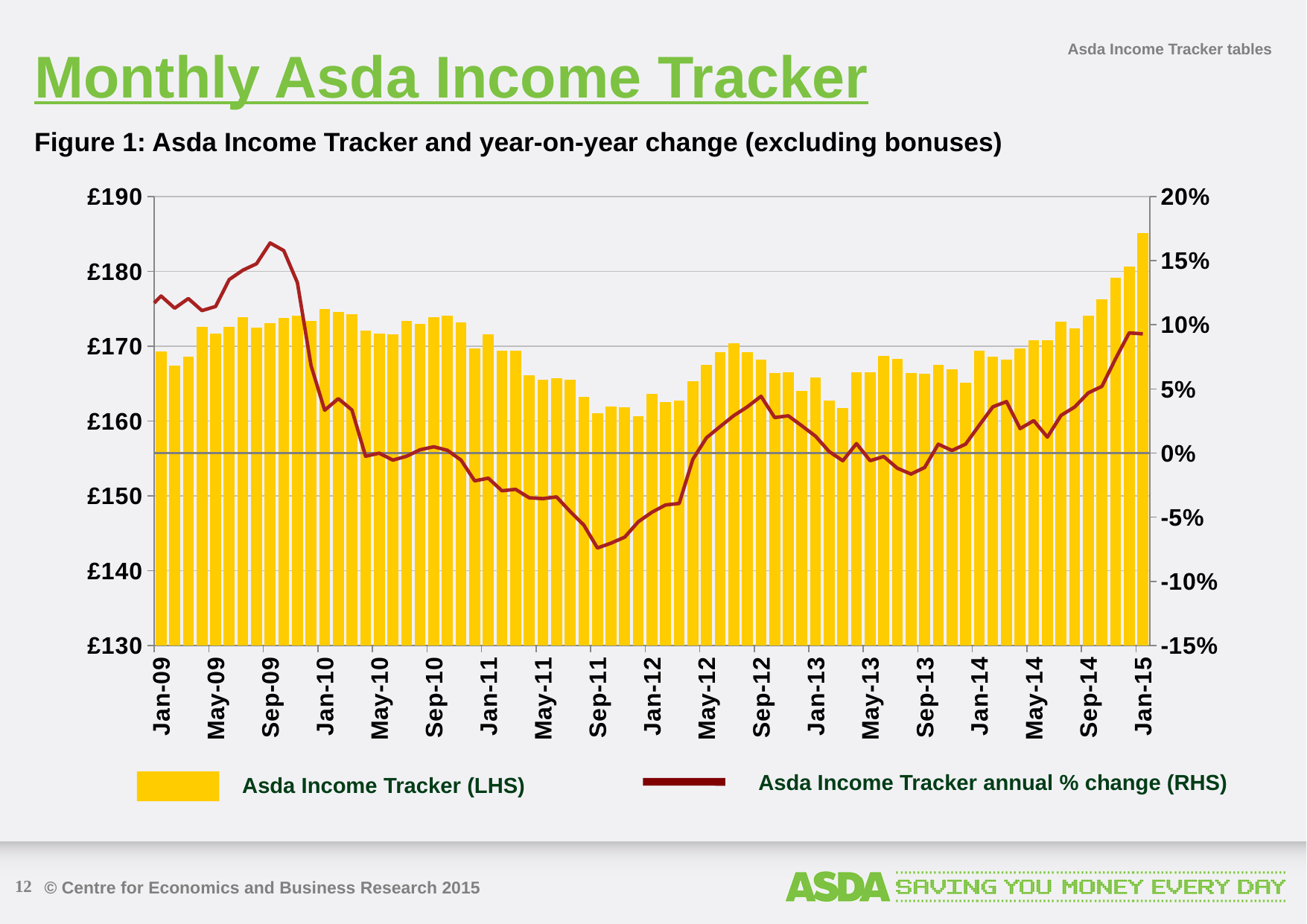
Is the annual % change for Sep-11 greater or less than -5%? less Is the Asda Income Tracker bar for Sep-11 greater or less than £170? less What kind of chart is shown in Figure 1? A combined bar and line chart What is the title of Figure 1? Asda Income Tracker and year-on-year change (excluding bonuses) Is the Asda Income Tracker bar for Jan-15 greater or less than £180? greater Which series is plotted as bars according to the legend? Asda Income Tracker (LHS) In which month does the annual % change line reach its highest point? Sep-09 In which month is the Asda Income Tracker bar highest? Jan-15 In which month does the annual % change line reach its lowest point? Sep-11 Which is larger, the Asda Income Tracker bar for Jan-09 or for Jan-15? Jan-15 How many series does the legend list? 2 Do the Asda Income Tracker bars rise or fall from Jan-14 to Jan-15? rise